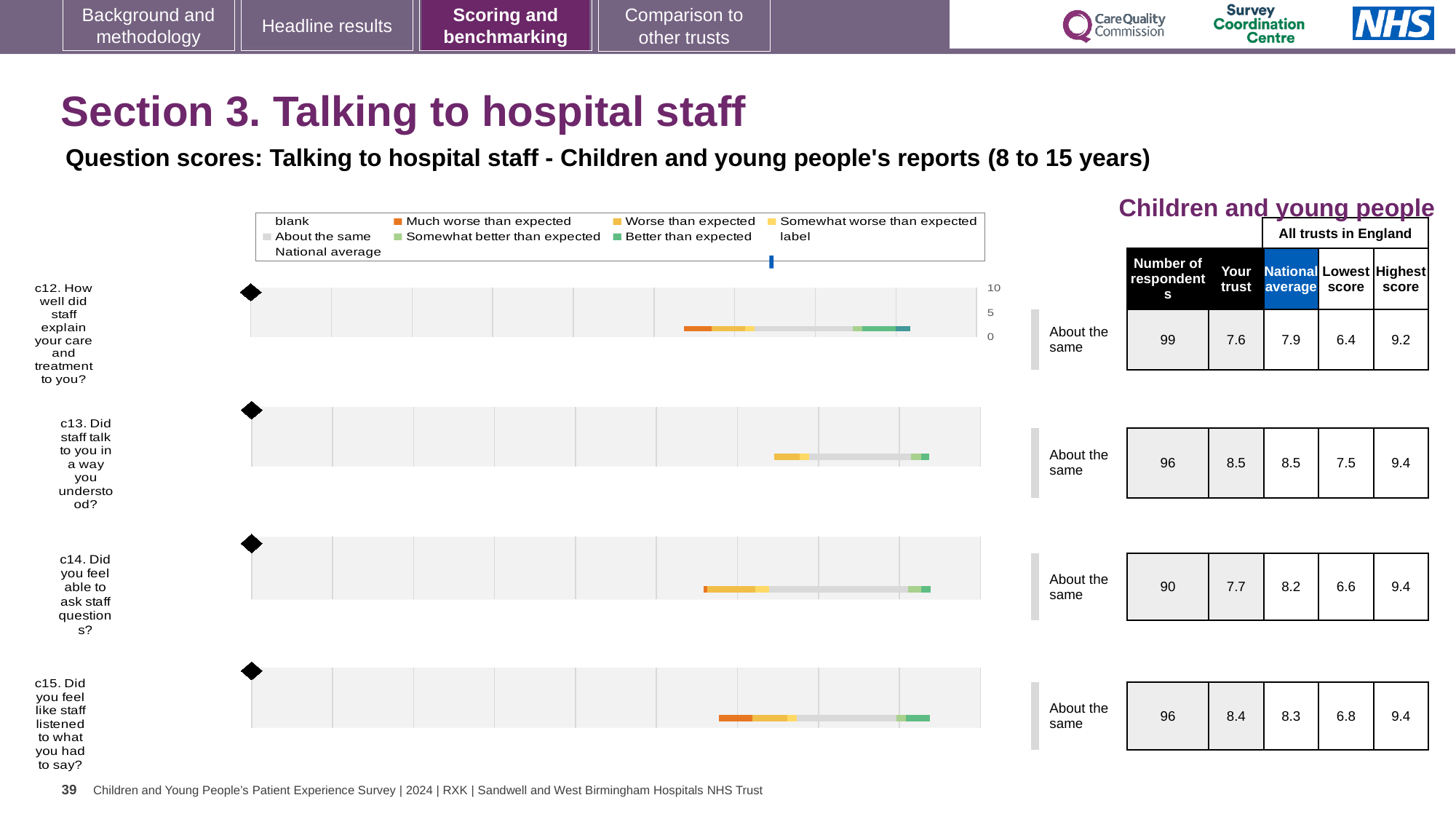
For question c15, which is larger: the 'Your trust' score or the national average score? Your trust Which of the four questions (c12 to c15) has the lowest 'Lowest score' among all trusts in England? c12. How well did staff explain your care and treatment to you? For question c12 (How well did staff explain your care and treatment to you?), what is the 'Your trust' score shown? 7.6 For question c15 (Did you feel like staff listened to what you had to say?), what is the highest score among all trusts in England? 9.4 What benchmark category is shown next to each of the four question charts? About the same What is the maximum value shown on the score axis of the question charts? 10 For question c14, what is the difference between the national average score and the 'Your trust' score? 0.5 What type of chart is used to show the question scores on this slide? Bar chart For question c14 (Did you feel able to ask staff questions?), how many respondents are shown? 90 For question c13 (Did staff talk to you in a way you understood?), what is the national average score shown? 8.5 How many question charts are shown on the slide? 4 Which of the four questions (c12 to c15) has the highest 'Your trust' score? c13. Did staff talk to you in a way you understood?